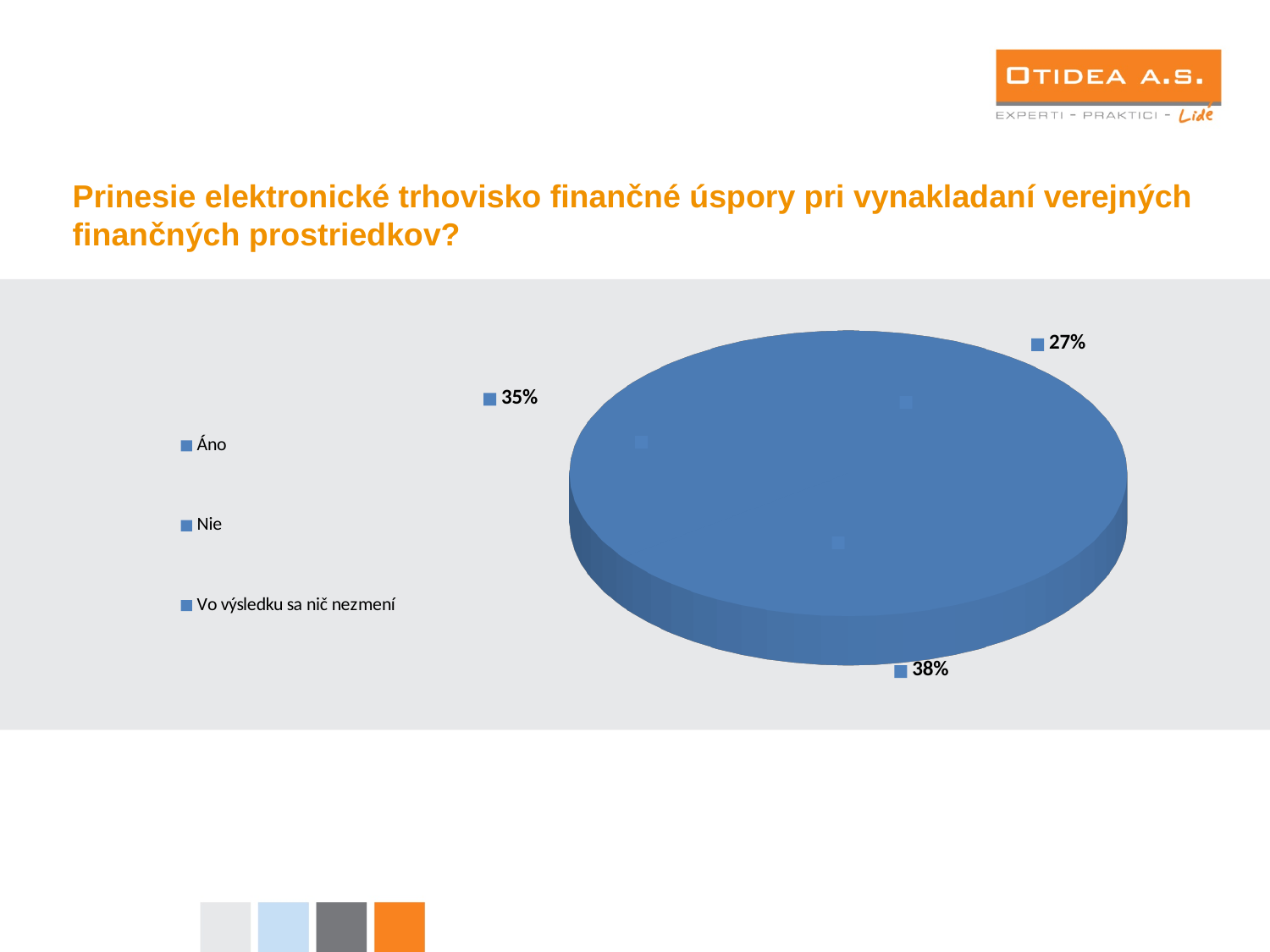
What is the difference between the 35% slice and the 27% slice on the pie chart? 8% What are the three legend entries of the pie chart? Áno, Nie, Vo výsledku sa nič nezmení Which is larger on the pie chart, the slice labelled 35% or the slice labelled 38%? 38% What question is posed in the title above the pie chart? Prinesie elektronické trhovisko finančné úspory pri vynakladaní verejných finančných prostriedkov? What is the difference between the largest and smallest percentages labelled on the pie chart? 11% What is the smallest percentage labelled on the pie chart? 27% How many slices does the pie chart have? 3 What kind of chart is shown on the slide? pie chart What do the three percentage labels on the pie chart add up to? 100% How many entries does the legend of the pie chart list? 3 What is the largest percentage labelled on the pie chart? 38%